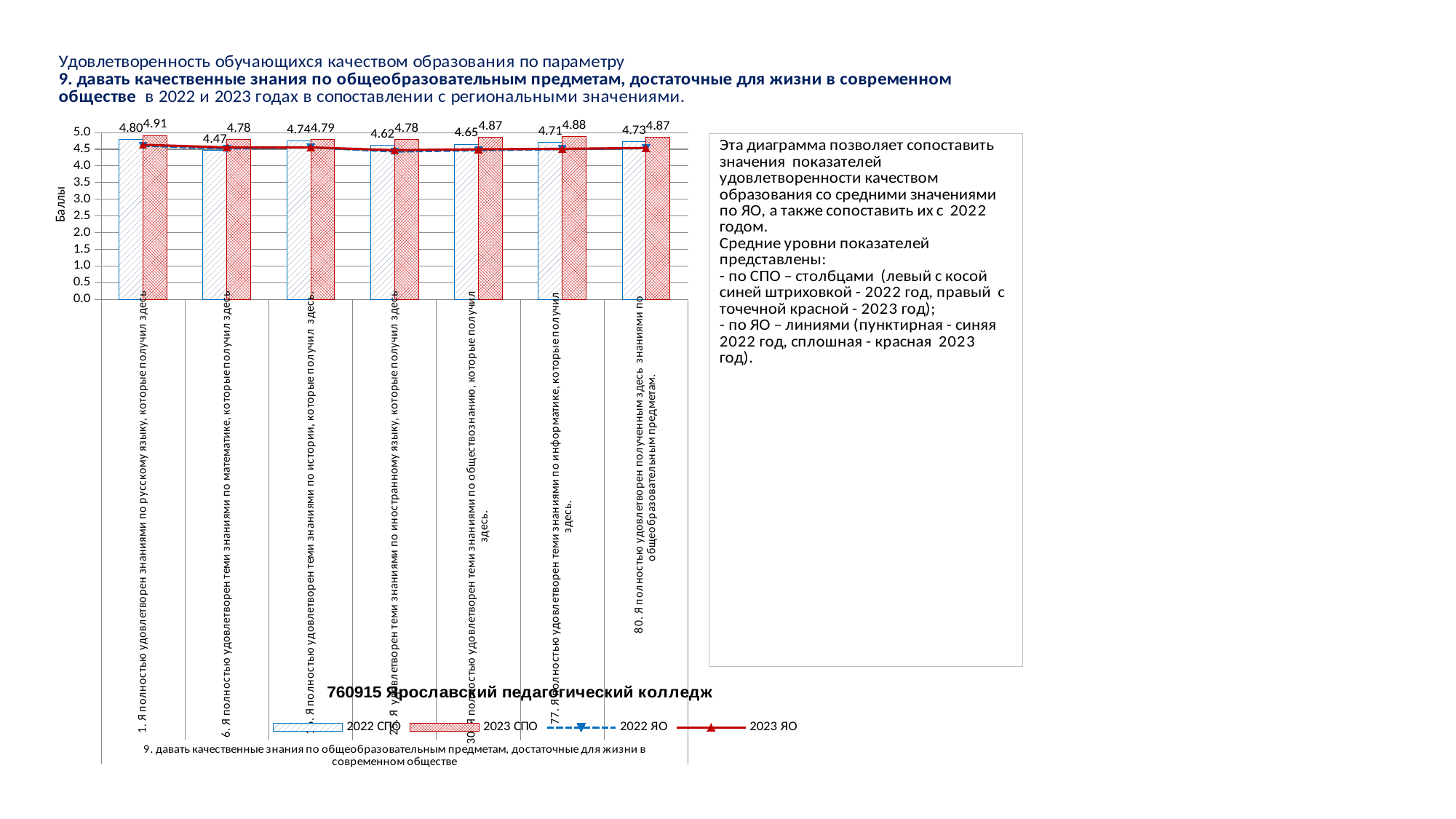
How many categories are shown on the x axis of the chart? 7 Which category has the highest 2023 СПО value? 1. Я полностью удовлетворен знаниями по русскому языку, которые получил здесь (4.91) What is the 2023 СПО value for the category about knowledge of informatics (информатике)? 4.88 What is the title of the vertical axis of the chart? Баллы Which category has the lowest 2022 СПО value? 6. Я полностью удовлетворен теми знаниями по математике, которые получил здесь (4.47) What is the 2022 СПО value for the category about knowledge of social studies (обществознанию)? 4.65 What is the 2023 СПО value for the category about knowledge of mathematics (математике)? 4.78 Is the 2023 ЯО line value for the mathematics category greater or less than 4.0? greater What is the difference between the 2023 СПО and 2022 СПО values for the mathematics category? 0.31 How many series does the chart legend list? 4 For the foreign language category (иностранному языку), which is larger: the 2022 СПО value or the 2023 СПО value? 2023 СПО (4.78) What is the 2022 СПО value for the category about knowledge of the Russian language (русскому языку)? 4.80